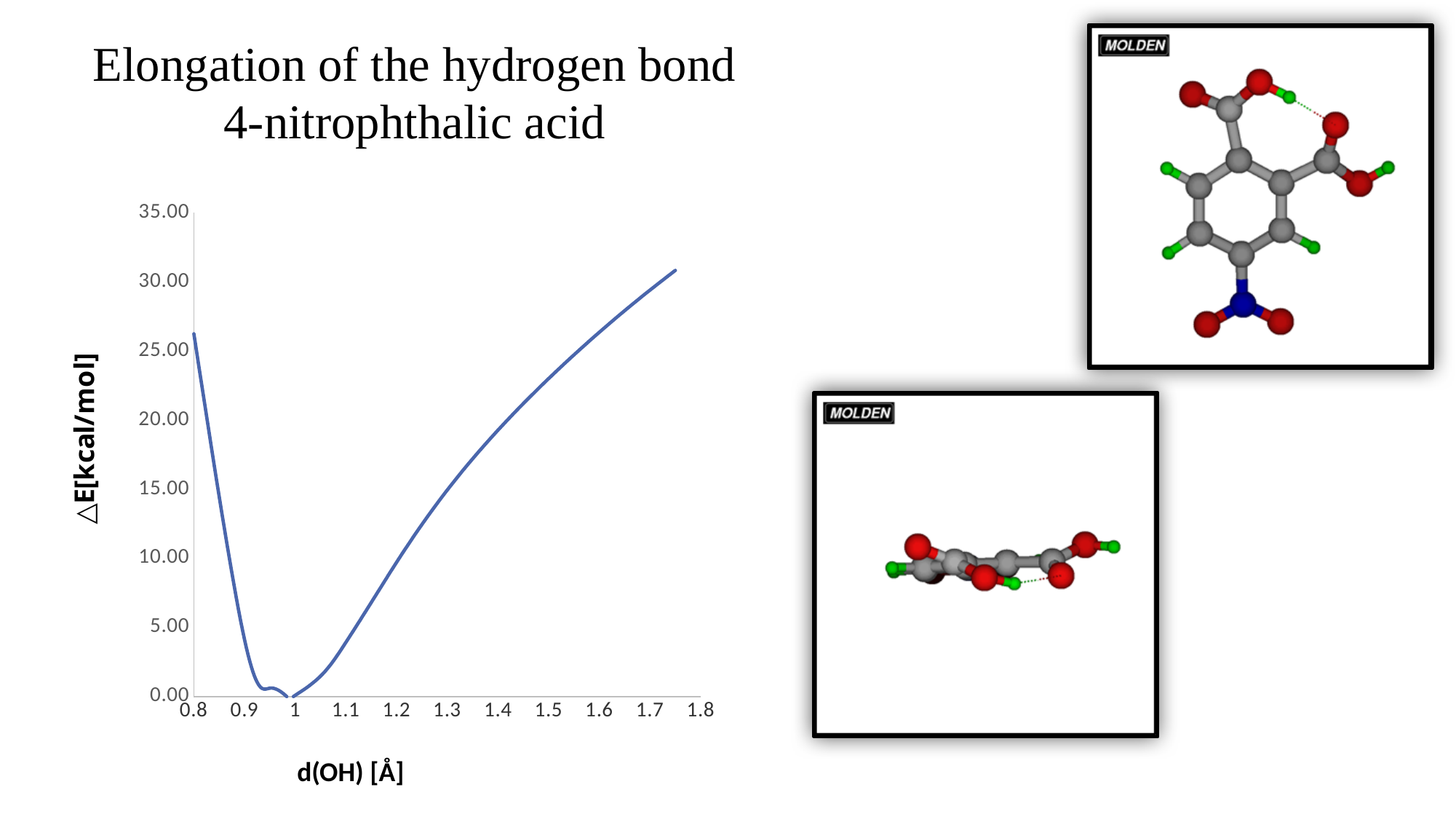
Does △E rise or fall as d(OH) increases from 1.0 to 1.7? rise Does △E rise or fall as d(OH) increases from 0.8 to 1.0? fall Is the value of △E at d(OH) = 1.1 greater or less than 5? less Is the value of △E at d(OH) = 1.5 greater or less than 20? greater Is the value of △E at d(OH) = 1.4 greater or less than 15? greater What is the label of the x axis of the chart? d(OH) [Å] What kind of chart is shown on the slide? line chart What is the label of the y axis of the chart? △E[kcal/mol] How many lines (series) are plotted on the chart? 1